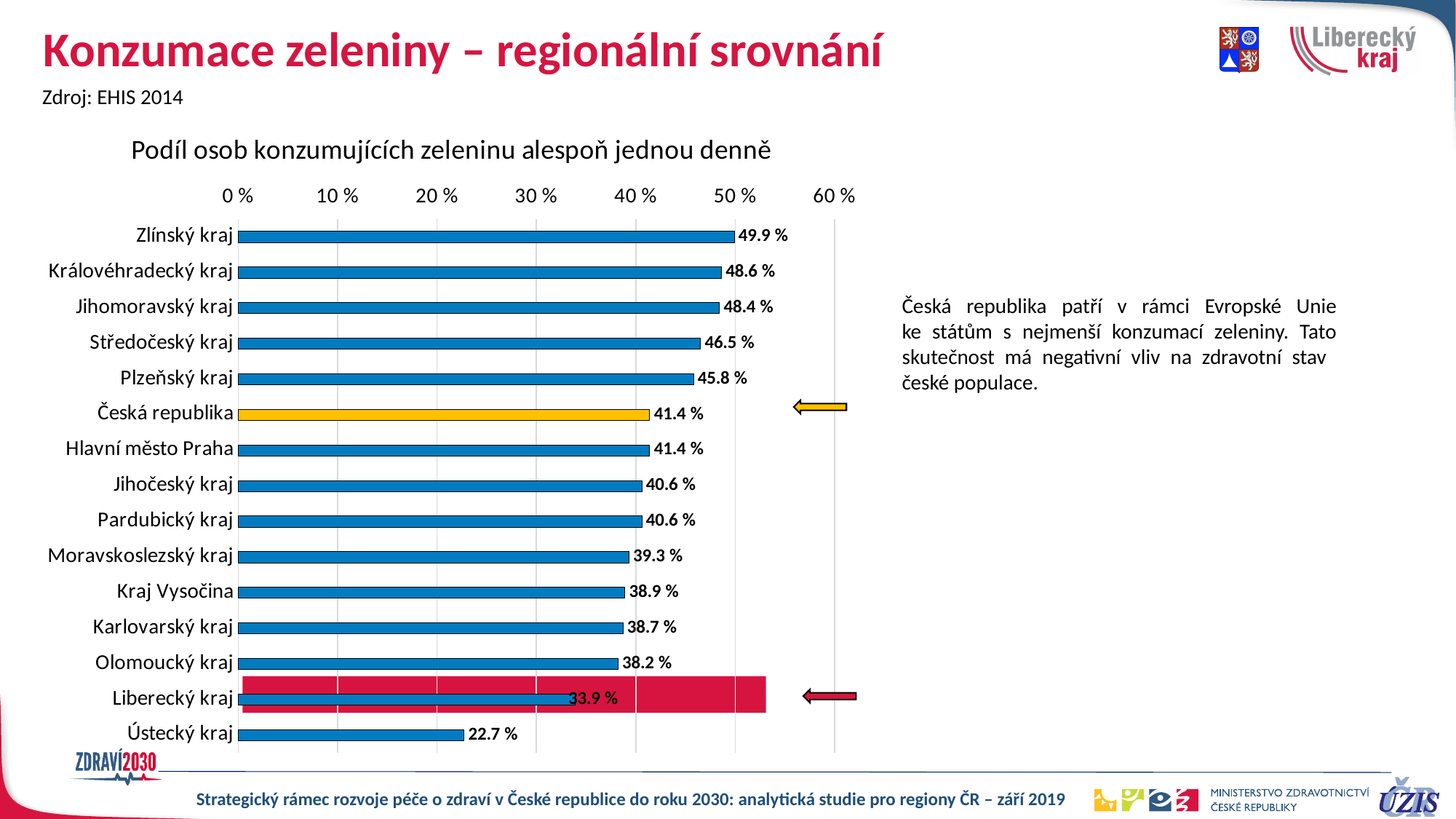
Which region has the highest value? Zlínský kraj What is the title of the chart? Podíl osob konzumujících zeleninu alespoň jednou denně What is the difference between the values for Zlínský kraj and Ústecký kraj? 27.2 % What is the value for Česká republika? 41.4 % What kind of chart is shown on the slide? bar chart What is the value for Středočeský kraj? 46.5 % Which is larger, the value for Plzeňský kraj or the value for Olomoucký kraj? Plzeňský kraj Which region has the lowest value? Ústecký kraj Is the value for Liberecký kraj greater or less than 40 %? less How many bars are shown in the chart? 15 What is the difference between the values for Česká republika and Liberecký kraj? 7.5 % What is the value for Liberecký kraj? 33.9 %